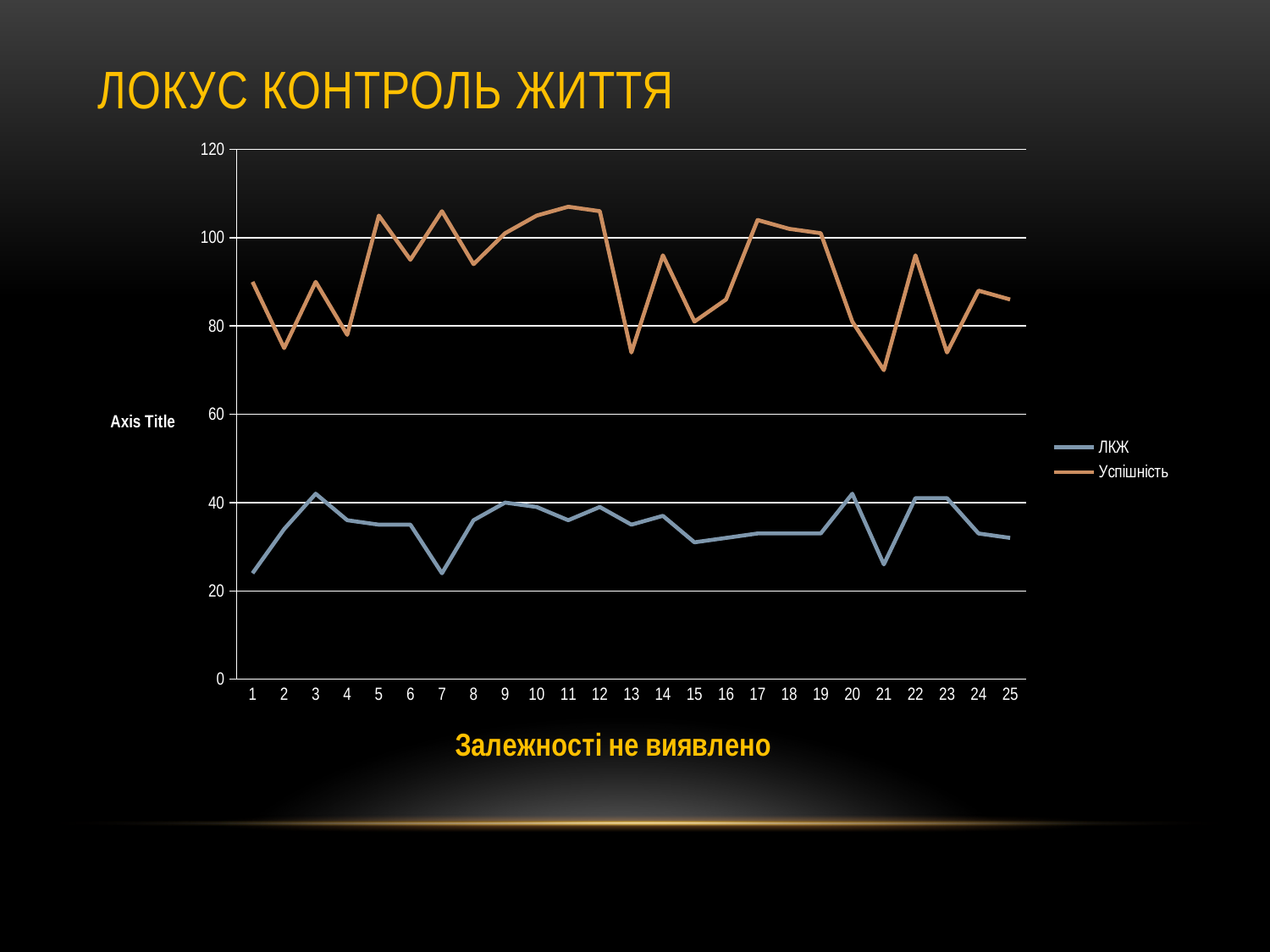
What are the two series names shown in the legend? ЛКЖ and Успішність How many points are plotted along the x axis for each series? 25 At point 13, which series has the larger value, ЛКЖ or Успішність? Успішність Is the value of ЛКЖ at point 1 greater or less than 40? less What kind of chart is shown on the slide? line chart For the ЛКЖ series, which is larger: the value at point 3 or the value at point 7? point 3 Is the value of ЛКЖ at point 7 greater or less than 40? less Is the value of Успішність at point 21 greater or less than 80? less What text is written in yellow below the chart? Залежності не виявлено How many series does the legend list? 2